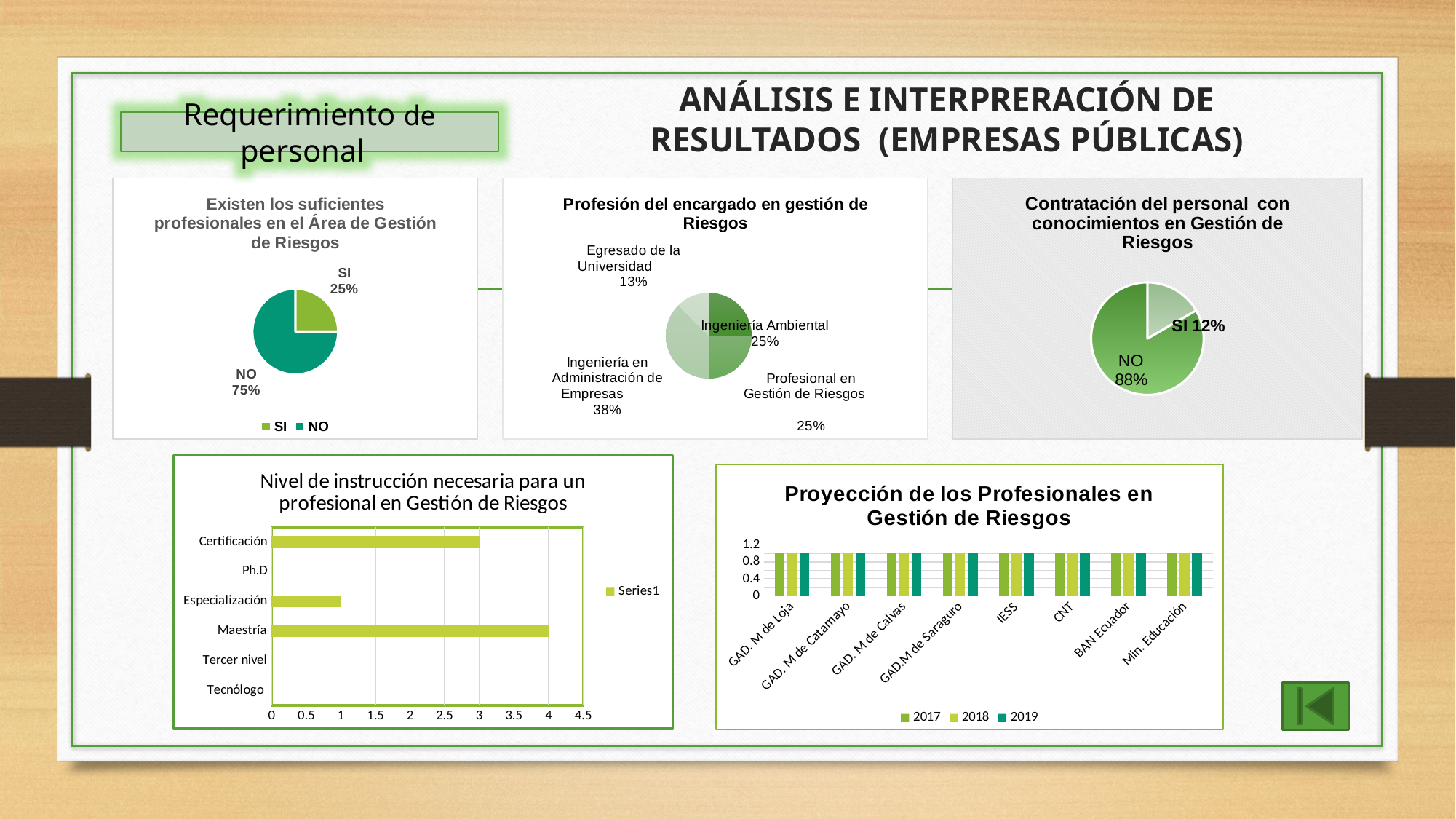
In the pie chart 'Contratación del personal con conocimientos en Gestión de Riesgos', what is the difference between NO and SI? 76% In the pie chart 'Profesión del encargado en gestión de Riesgos', which category has the smallest share? Egresado de la Universidad In the pie chart 'Existen los suficientes profesionales en el Área de Gestión de Riesgos', what share does NO have? 75% In the pie chart 'Profesión del encargado en gestión de Riesgos', how many slices are there? 4 In the chart 'Nivel de instrucción necesaria para un profesional en Gestión de Riesgos', which is larger, Certificación or Especialización? Certificación In the chart 'Proyección de los Profesionales en Gestión de Riesgos', how many series does the legend list? 3 In the chart 'Proyección de los Profesionales en Gestión de Riesgos', how many categories are shown on the x axis? 8 In the chart 'Nivel de instrucción necesaria para un profesional en Gestión de Riesgos', which category has the highest value? Maestría In the chart 'Nivel de instrucción necesaria para un profesional en Gestión de Riesgos', what is the value for Maestría? 4 In the pie chart 'Existen los suficientes profesionales en el Área de Gestión de Riesgos', what is the value for SI? 25% In the pie chart 'Contratación del personal con conocimientos en Gestión de Riesgos', what is the value for NO? 88% In the pie chart 'Profesión del encargado en gestión de Riesgos', which profession has the largest share? Ingeniería en Administración de Empresas